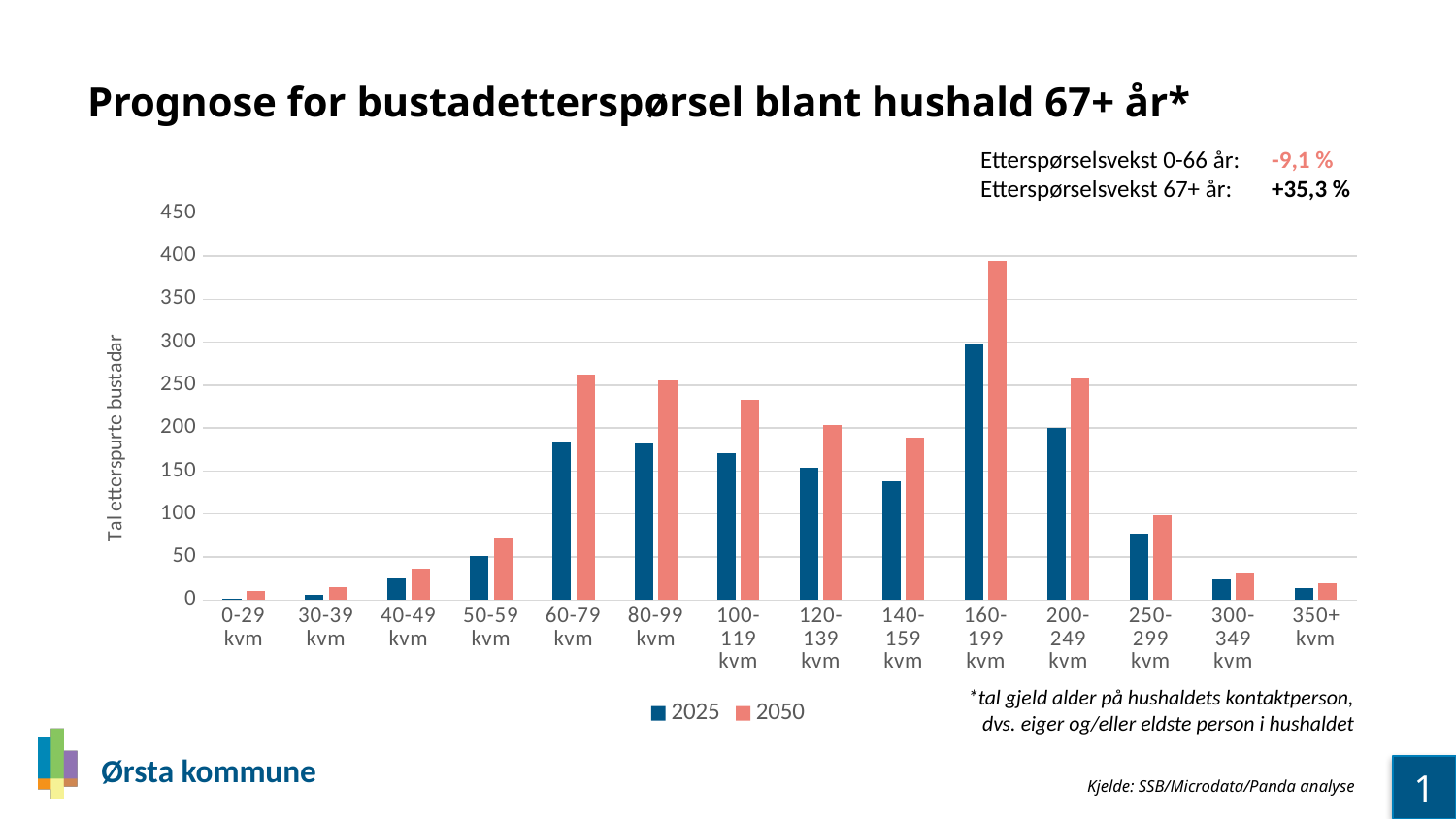
Is the 2050 value for 60-79 kvm greater or less than 200? greater What is the label on the vertical axis of the chart? Tal etterspurte bustadar Which size category has the highest value for the 2050 series? 160-199 kvm Which size category has the lowest value for the 2025 series? 0-29 kvm What kind of chart is shown on the slide? bar chart How many size categories (kvm groups) are shown on the x axis? 14 For 160-199 kvm, which series has the larger value, 2025 or 2050? 2050 For the 2025 series, which is larger: the value for 60-79 kvm or the value for 120-139 kvm? 60-79 kvm Is the 2050 value for 160-199 kvm greater or less than 350? greater Is the 2025 value for 140-159 kvm greater or less than 150? less Which size category has the highest value for the 2025 series? 160-199 kvm How many series does the legend list? 2